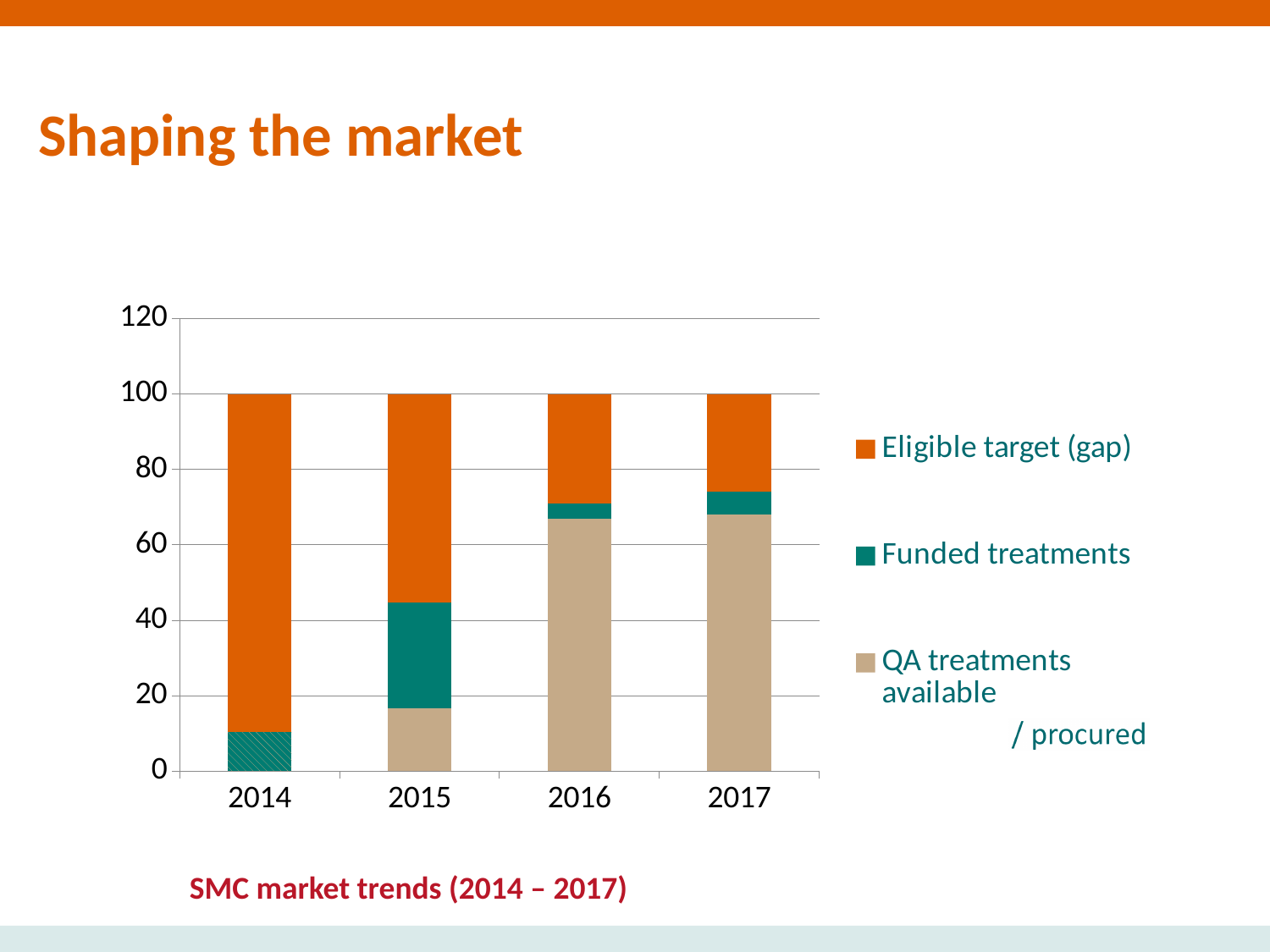
What is the caption shown below the chart? SMC market trends (2014 – 2017) Is the Funded treatments segment larger in 2015 or in 2016? 2015 How many series does the chart's legend list? 3 Which year has the largest Funded treatments segment? 2015 Is the value for QA treatments available in 2015 greater or less than 40? less How many years are shown on the x axis of the chart? 4 Which year has the largest Eligible target (gap) segment? 2014 Does the Eligible target (gap) segment rise or fall from 2014 to 2017? fall What is the total height of the stacked bar for 2015? 100 Is the value for Funded treatments in 2015 greater or less than 20? greater Is the value for QA treatments available in 2016 greater or less than 60? greater What kind of chart is shown on the slide? Stacked bar chart